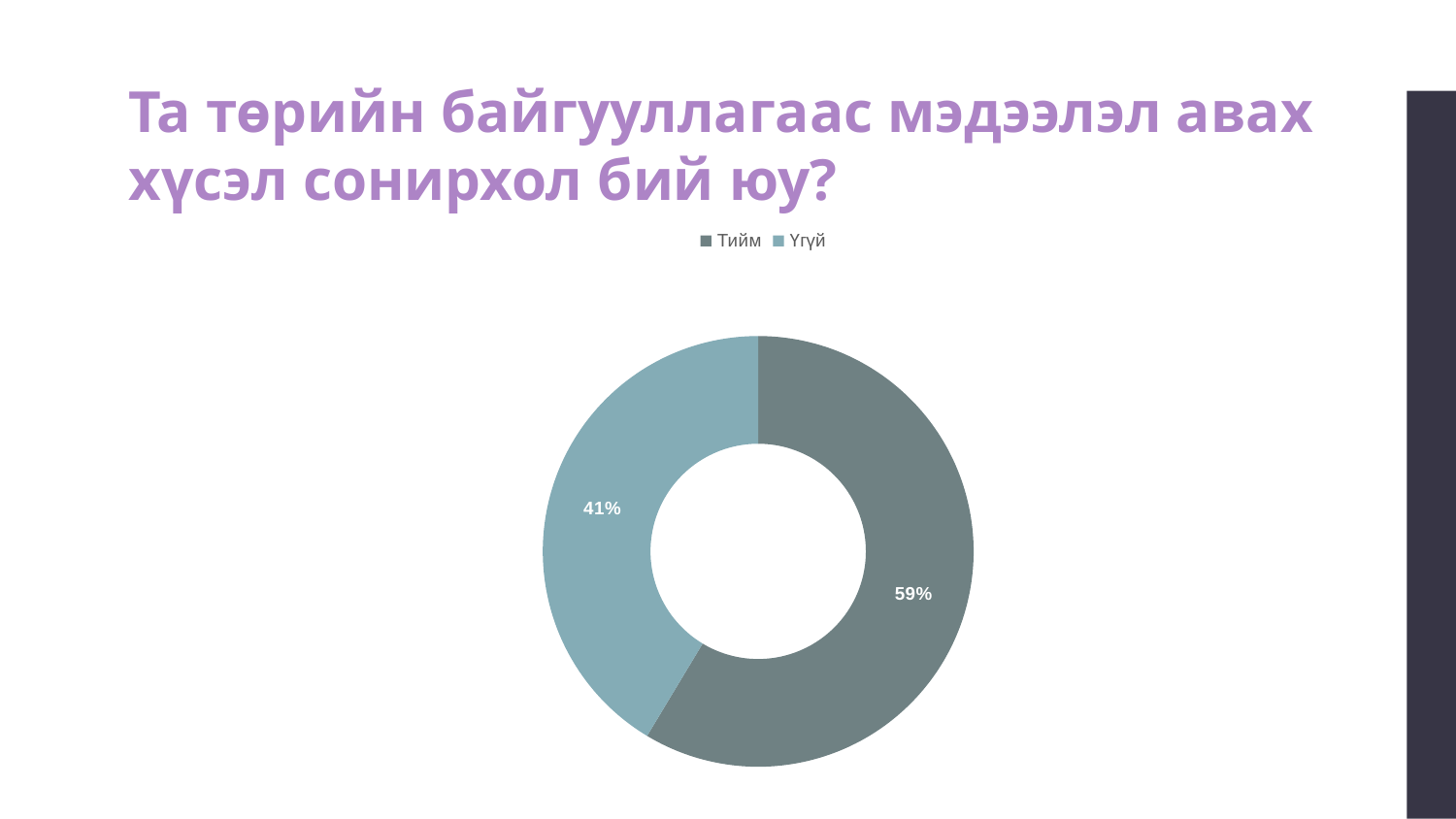
What kind of chart is shown on the slide? Doughnut (pie) chart How many entries does the legend list? 2 What share of the doughnut chart is labelled Тийм? 59% What is the difference in percentage points between the Тийм and Үгүй slices? 18 What share of the doughnut chart is labelled Үгүй? 41% Which slice is larger, Тийм or Үгүй? Тийм Which category has the largest share in the chart? Тийм What is the title shown above the chart? Та төрийн байгууллагаас мэдээлэл авах хүсэл сонирхол бий юу? Which category has the smallest share in the chart? Үгүй How many slices does the chart have? 2 Which legend entry is shown first, on the left? Тийм What is the combined share of the Тийм and Үгүй slices? 100%